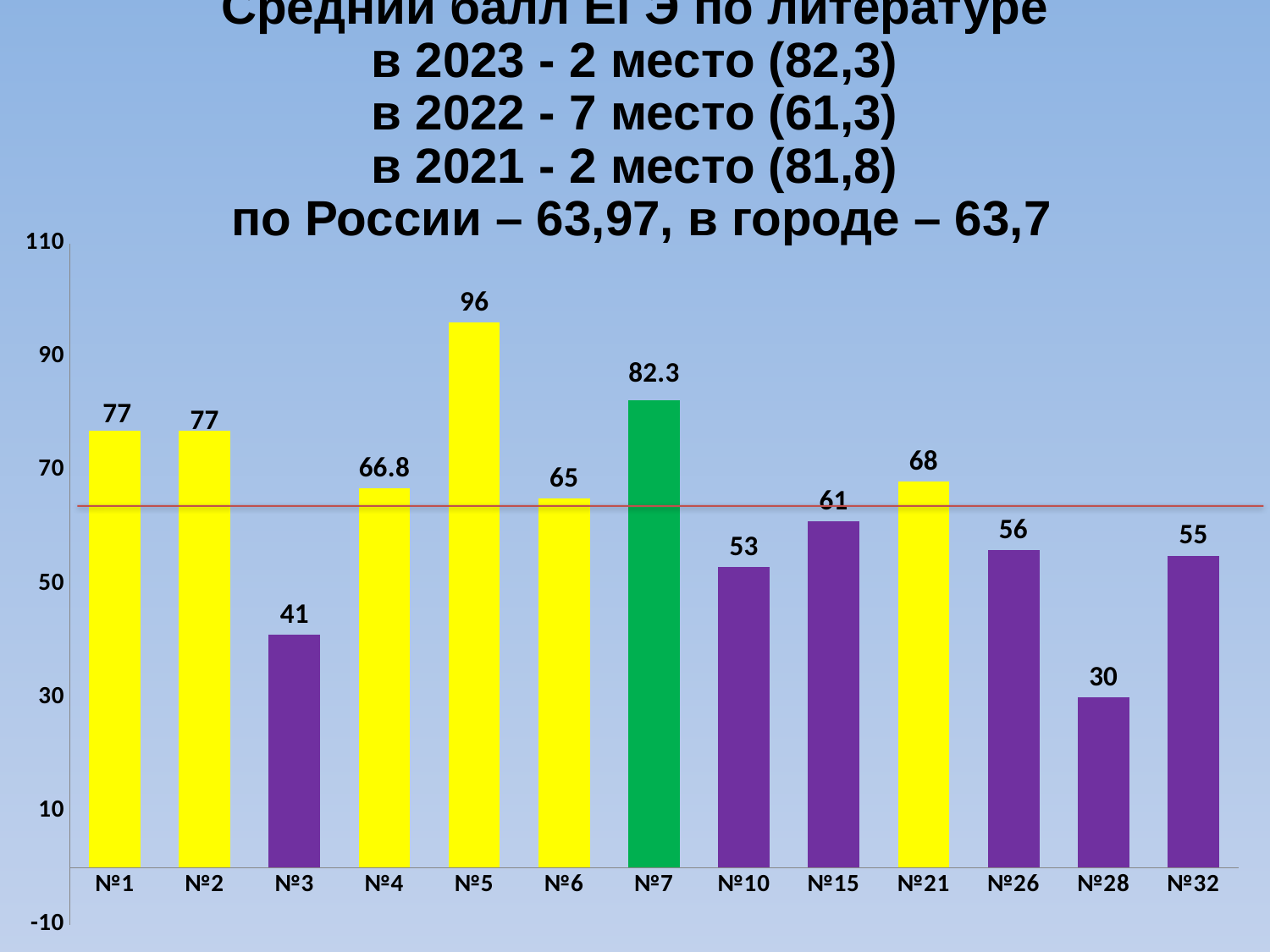
Which is larger, the value for №15 or the value for №26? №15 How many categories are shown on the x axis? 13 What is the difference between the values for №5 and №7? 13.7 What is the value for №4? 66.8 What is the value for №28? 30 What colour is the bar for №7? green Which category has the lowest value? №28 What is the difference between the values for №21 and №3? 27 What is the value for №7? 82.3 What is the value for №5? 96 What kind of chart is shown on the slide? bar chart Which category has the highest value? №5